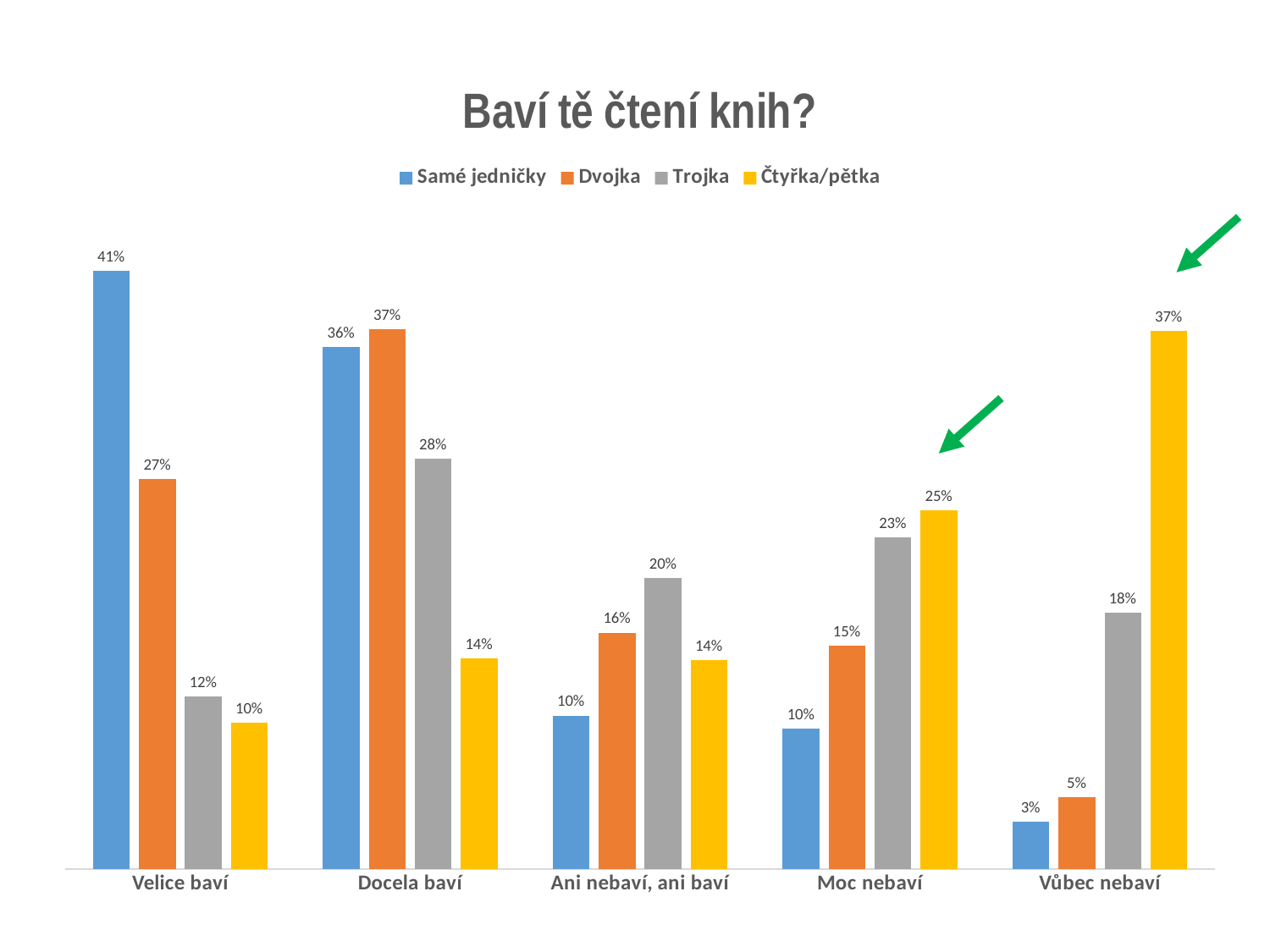
What is the difference between the Čtyřka/pětka value and the Samé jedničky value in the Vůbec nebaví category? 34% What kind of chart is shown on the slide? Bar chart What is the value for Trojka in the Moc nebaví category? 23% What is the value for Samé jedničky in the Velice baví category? 41% What is the title of the chart? Baví tě čtení knih? In the Docela baví category, which is larger: Samé jedničky or Dvojka? Dvojka How many categories are shown on the x axis? 5 What is the value for Čtyřka/pětka in the Vůbec nebaví category? 37% Do the values for Samé jedničky rise or fall from Velice baví to Vůbec nebaví? Fall Which category has the lowest value for Dvojka? Vůbec nebaví Which category has the highest value for Samé jedničky? Velice baví How many series does the legend list? 4